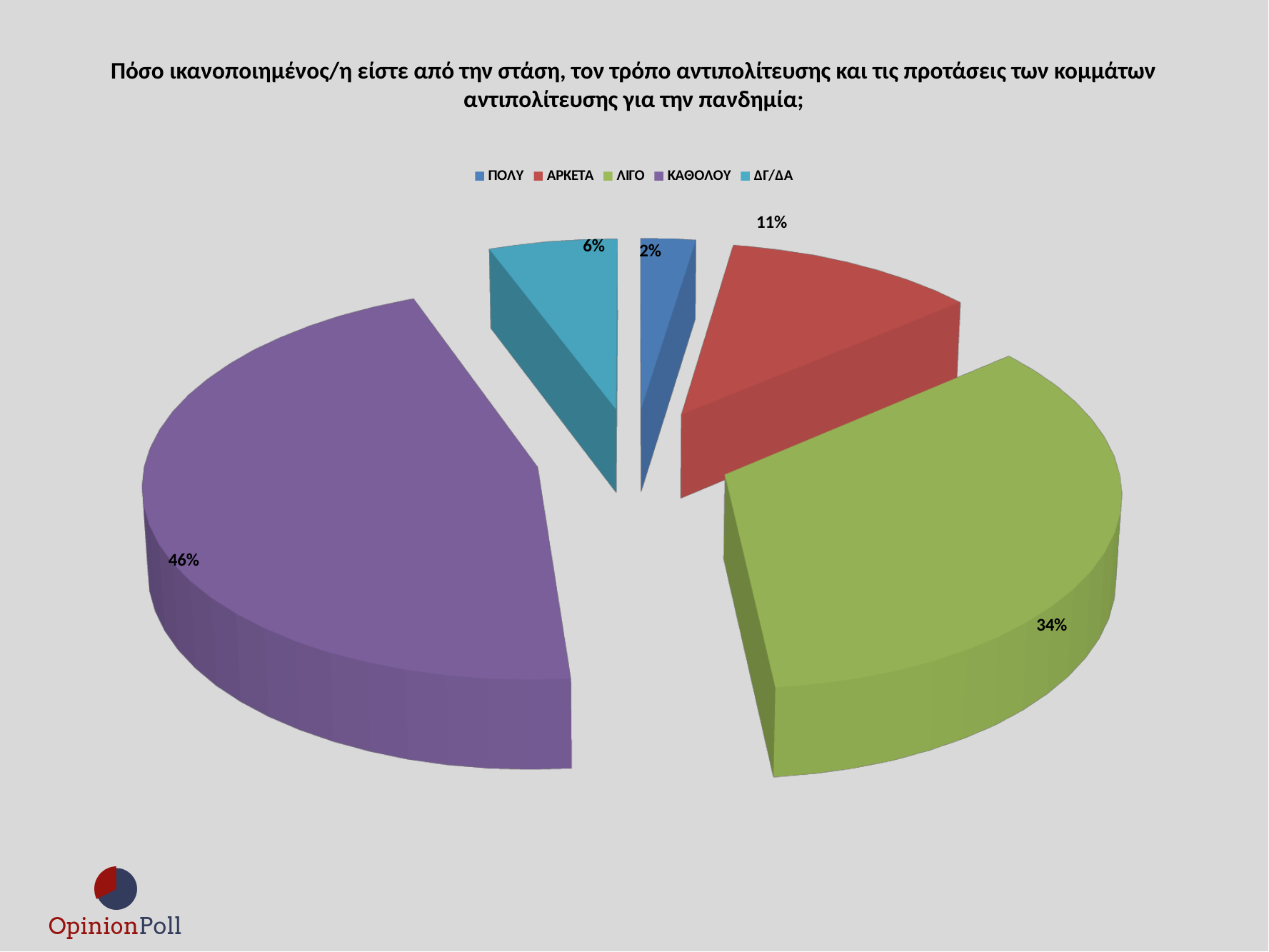
Which category has the smallest slice of the pie? ΠΟΛΥ What is the difference in percentage points between the ΚΑΘΟΛΟΥ and ΛΙΓΟ slices? 12 What percentage of the pie is labelled ΔΓ/ΔΑ? 6% What percentage of the pie is labelled ΑΡΚΕΤΑ? 11% What colour is the ΛΙΓΟ slice? Green Which slice is larger, ΑΡΚΕΤΑ or ΔΓ/ΔΑ? ΑΡΚΕΤΑ Which category has the largest slice of the pie? ΚΑΘΟΛΟΥ How many categories does the legend list? 5 What kind of chart is shown on the slide? Pie chart What percentage of the pie is labelled ΛΙΓΟ? 34% What percentage of the pie is labelled ΠΟΛΥ? 2% What percentage of the pie is labelled ΚΑΘΟΛΟΥ? 46%